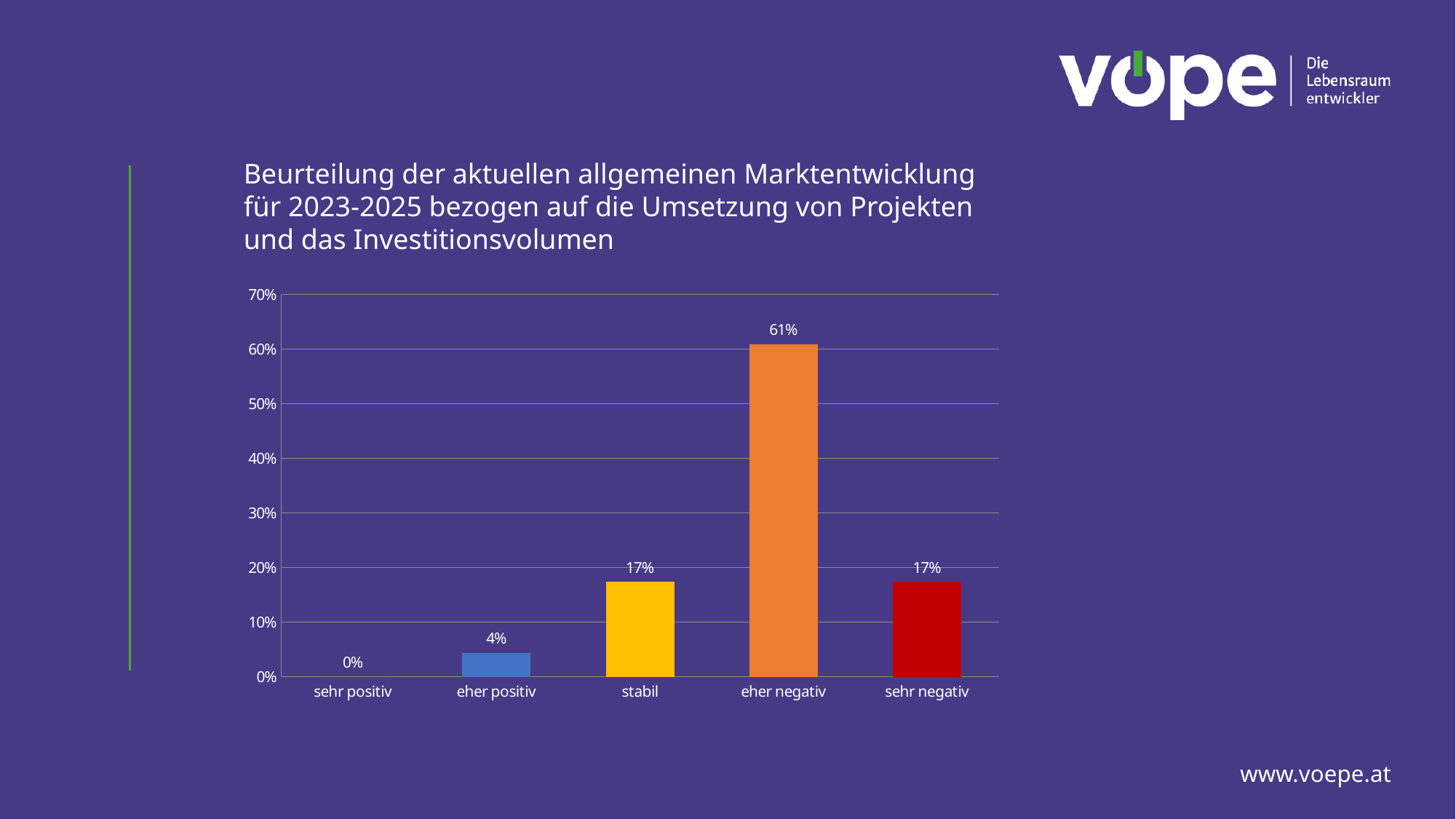
Which category has the lowest value? sehr positiv What colour is the bar for "stabil"? yellow What is the value for "eher positiv"? 4% What is the difference between the values for "eher negativ" and "sehr negativ"? 44% What is the value for "eher negativ"? 61% Which is larger, the value for "eher positiv" or the value for "stabil"? stabil Which category has the highest value? eher negativ How many categories are shown on the x axis? 5 What kind of chart is shown on the slide? bar chart What is the value for "sehr positiv"? 0% Is the value for "eher negativ" greater or less than 50%? greater What is the value for "stabil"? 17%